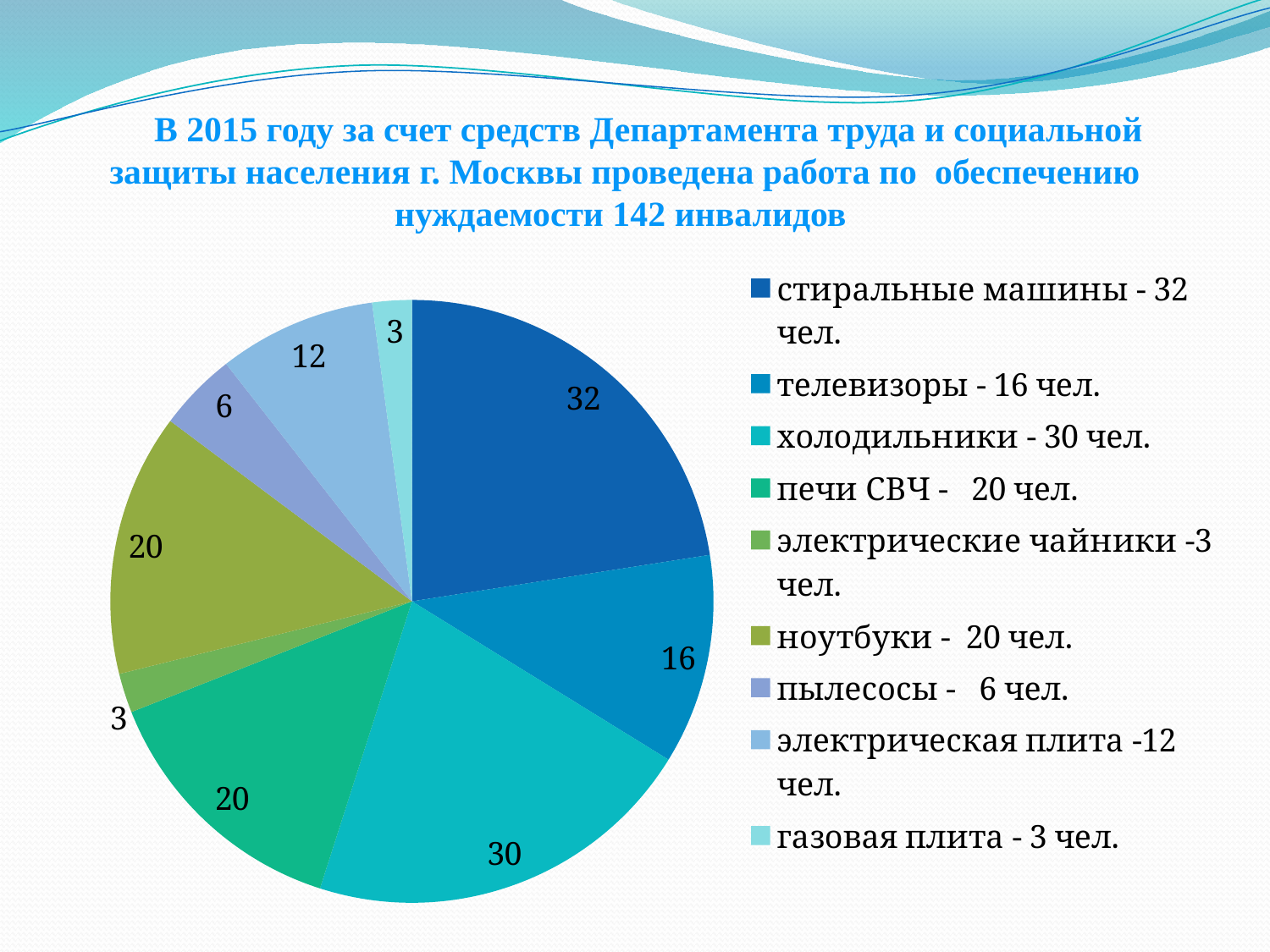
What is the value for стиральные машины in the pie chart? 32 What is the value for пылесосы in the pie chart? 6 What is the difference between the values for холодильники and ноутбуки? 10 What kind of chart is shown on the slide? pie chart Which category has the largest slice in the pie chart? стиральные машины Which is larger in the pie chart, the value for телевизоры or the value for электрическая плита? телевизоры What is the value for электрическая плита in the pie chart? 12 What is the value for холодильники in the pie chart? 30 What is the difference between the values for стиральные машины and телевизоры? 16 How many entries does the legend of the pie chart list? 9 According to the slide title, how many disabled people in total were provided for in 2015? 142 How many slices does the pie chart have? 9